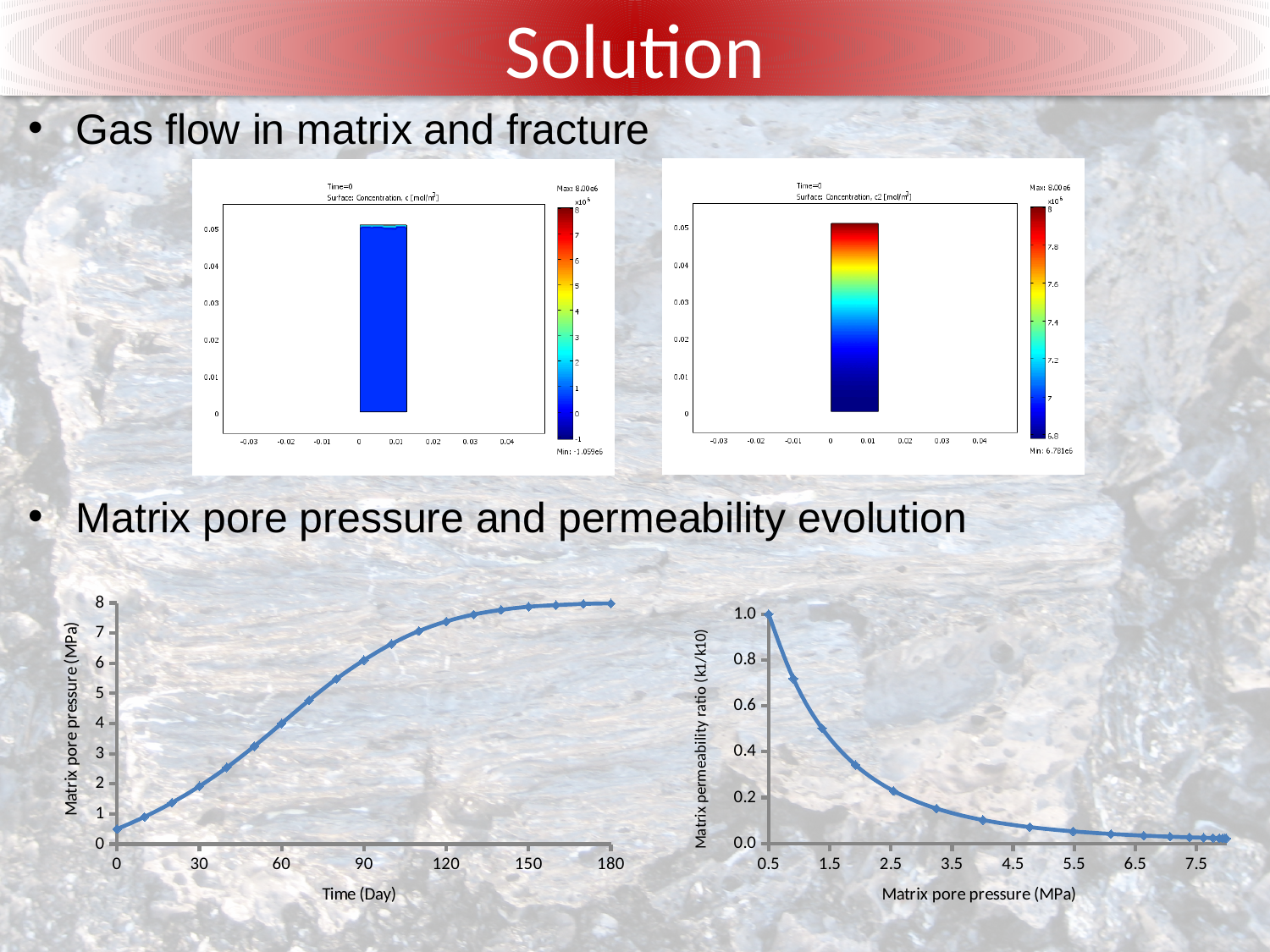
In the bottom-left chart, which time has the higher matrix pore pressure, 30 days or 150 days? 150 days In the bottom-left chart (Matrix pore pressure vs Time), do the values rise or fall as time increases? rise In the bottom-left chart, is the matrix pore pressure at 180 days greater or less than 7 MPa? greater In the bottom-left chart, is the matrix pore pressure at 120 days greater or less than 7 MPa? greater In the bottom-right chart, what is the matrix permeability ratio at a matrix pore pressure of 0.5 MPa? 1.0 In the bottom-right chart, is the matrix permeability ratio at a matrix pore pressure of 7.5 MPa greater or less than 0.2? less In the bottom-right chart (Matrix permeability ratio vs Matrix pore pressure), do the values rise or fall as matrix pore pressure increases? fall What is the y-axis title of the bottom-left chart? Matrix pore pressure (MPa) What is the x-axis title of the bottom-right chart? Matrix pore pressure (MPa) What kind of chart is the chart titled with the x axis 'Time (Day)' on the bottom left of the slide? line chart